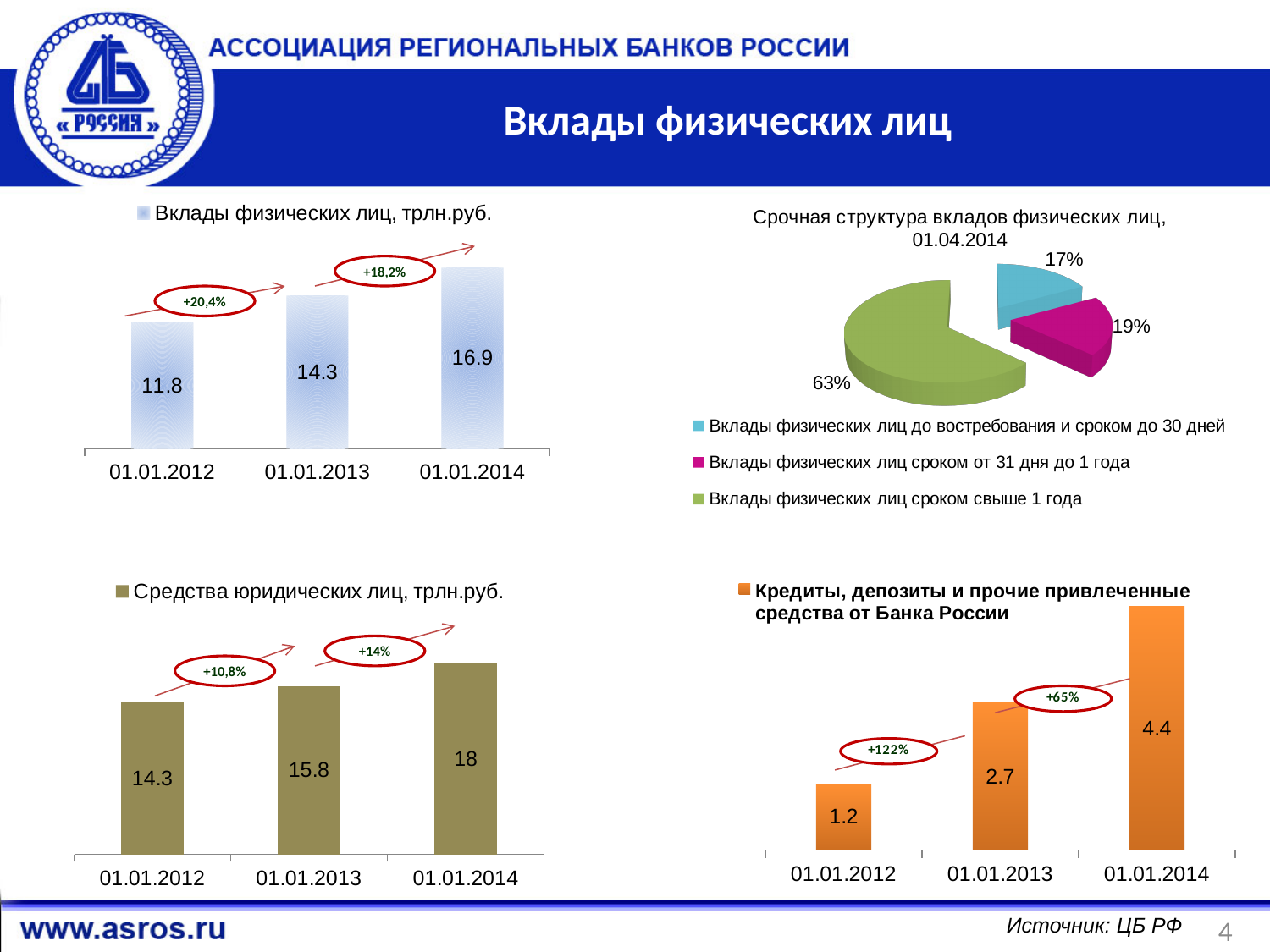
How many categories does the legend of the top-right pie chart list? 3 In the top-left chart 'Вклады физических лиц, трлн.руб.', what is the difference between the values for 01.01.2013 and 01.01.2012? 2.5 What type of chart is the top-right chart 'Срочная структура вкладов физических лиц, 01.04.2014'? pie chart In the top-right pie chart 'Срочная структура вкладов физических лиц, 01.04.2014', which category has the smallest share? Вклады физических лиц до востребования и сроком до 30 дней In the top-left chart 'Вклады физических лиц, трлн.руб.', what is the value for 01.01.2014? 16.9 In the top-left chart 'Вклады физических лиц, трлн.руб.', do the values rise or fall from 01.01.2012 to 01.01.2014? rise In the bottom-right chart 'Кредиты, депозиты и прочие привлеченные средства от Банка России', what is the value for 01.01.2012? 1.2 In the top-right pie chart 'Срочная структура вкладов физических лиц, 01.04.2014', what share do deposits with a term over 1 year (свыше 1 года) have? 63% In the top-left chart 'Вклады физических лиц, трлн.руб.', what growth percentage is shown between 01.01.2012 and 01.01.2013? +20,4% In the bottom-left chart 'Средства юридических лиц, трлн.руб.', which date has the highest value? 01.01.2014 In the bottom-right chart 'Кредиты, депозиты и прочие привлеченные средства от Банка России', what is the difference between the values for 01.01.2014 and 01.01.2013? 1.7 In the bottom-left chart 'Средства юридических лиц, трлн.руб.', what is the value for 01.01.2013? 15.8